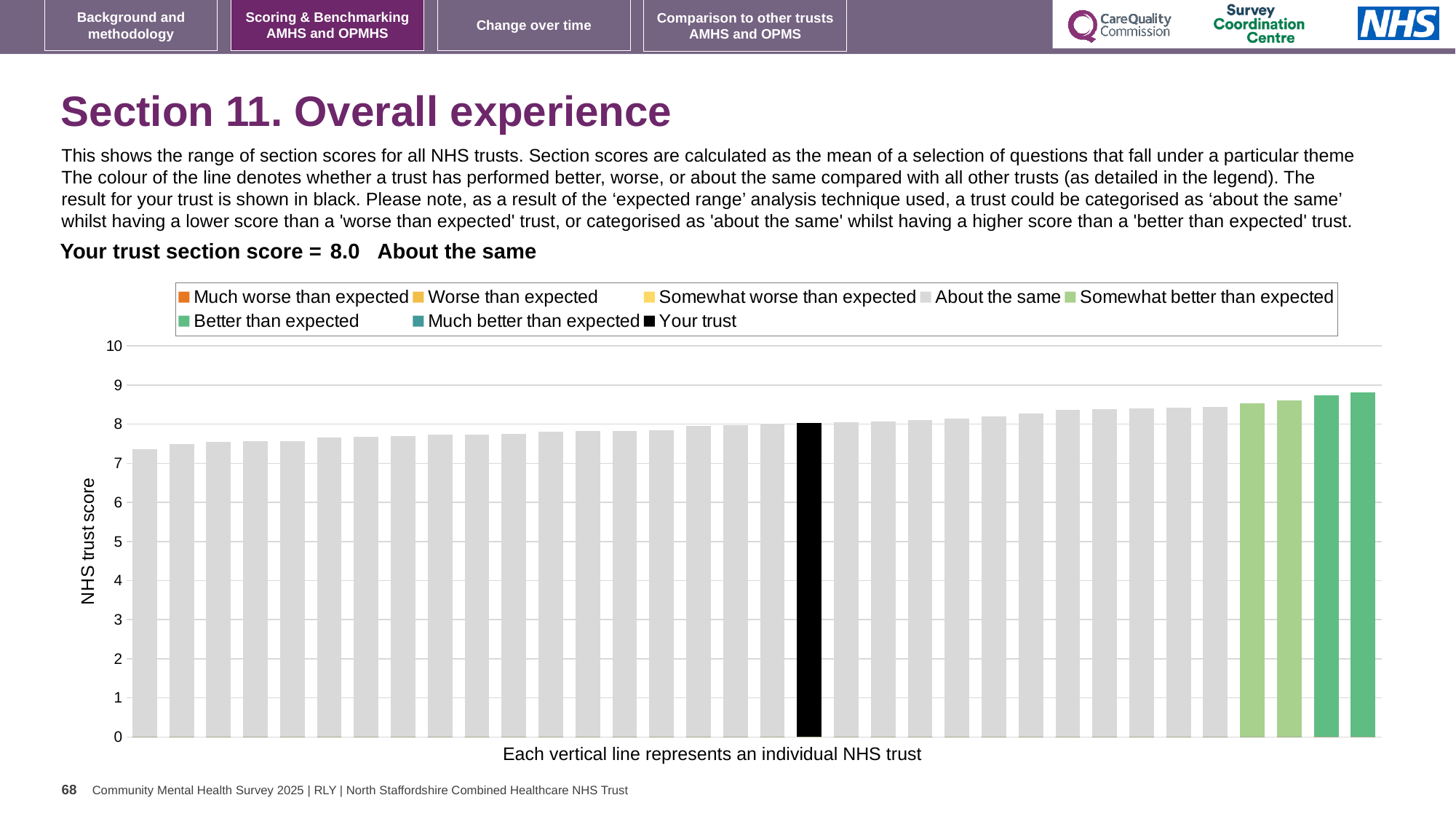
Which is larger, the rightmost bar or the black 'Your trust' bar? the rightmost bar Is the value of the rightmost bar greater or less than 8? greater Is the value of the black 'Your trust' bar greater or less than 5? greater How many entries does the chart legend list? 8 How many bars are coloured green? 4 What is the section score for your trust shown on the slide? 8.0 Is the value of the leftmost bar greater or less than 8? less What is the label on the vertical axis of the chart? NHS trust score What kind of chart is shown on the slide? bar chart Which category is your trust's section score placed in? About the same Do the bar values rise or fall from left to right along the x axis? rise